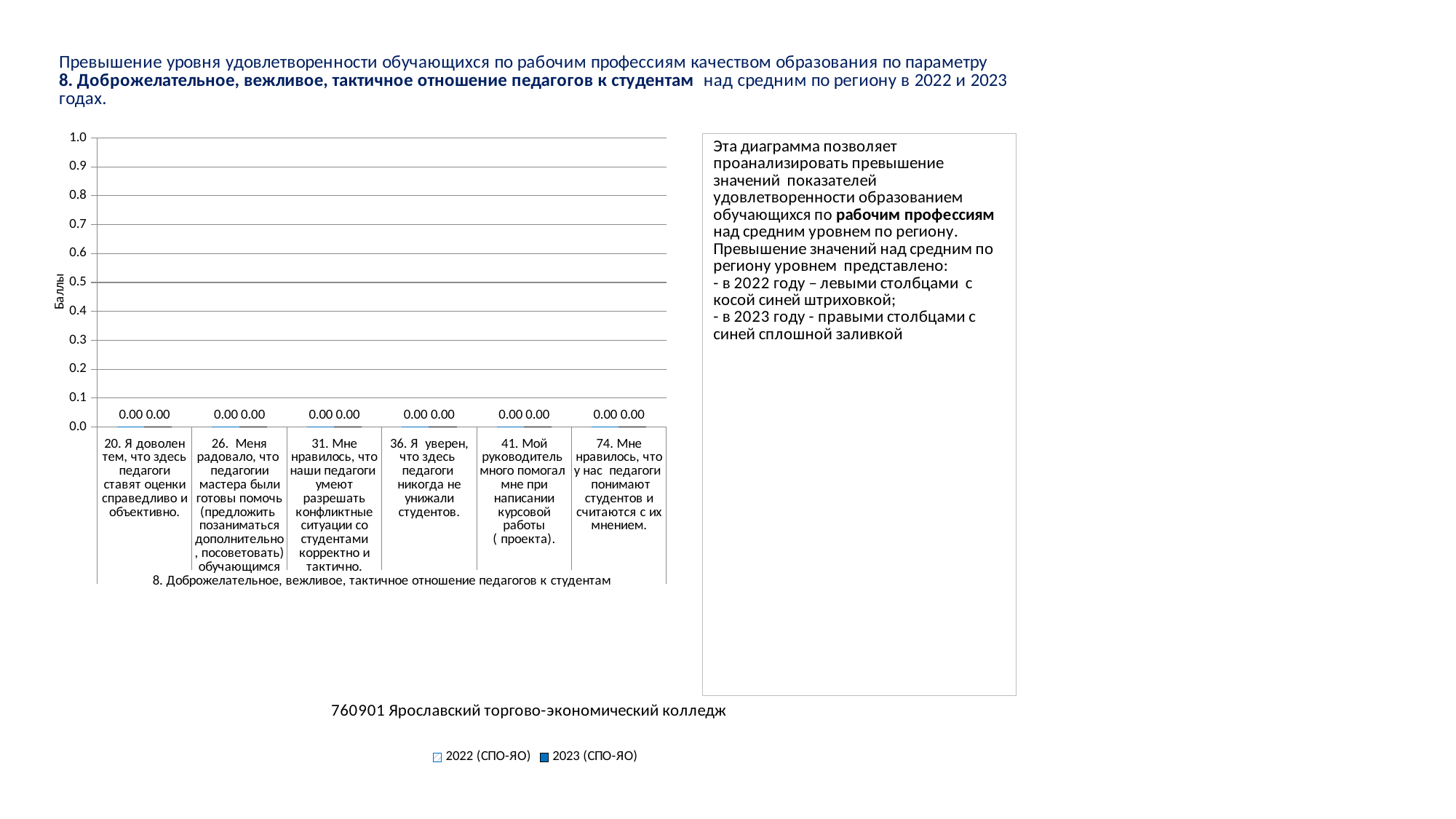
What is the 2023 (СПО-ЯО) value for category "74. Мне нравилось, что у нас педагоги понимают студентов и считаются с их мнением."? 0.00 What is the difference between the 2022 (СПО-ЯО) and 2023 (СПО-ЯО) values for category "31. Мне нравилось, что наши педагоги умеют разрешать конфликтные ситуации со студентами корректно и тактично."? 0.00 How many categories are shown on the x axis of the chart? 6 What kind of chart is shown on the slide? bar chart What is the label of the vertical axis of the chart? Баллы What is the 2023 (СПО-ЯО) value for category "20. Я доволен тем, что здесь педагоги ставят оценки справедливо и объективно."? 0.00 Do the values rise, fall, or stay the same across the categories along the x axis? stay the same How many series does the chart legend list? 2 What is the 2022 (СПО-ЯО) value for category "41. Мой руководитель много помогал мне при написании курсовой работы ( проекта)."? 0.00 What are the two series names listed in the chart legend? 2022 (СПО-ЯО) and 2023 (СПО-ЯО) What is the 2022 (СПО-ЯО) value for category "36. Я уверен, что здесь педагоги никогда не унижали студентов."? 0.00 Is the 2023 (СПО-ЯО) value for category "26. Меня радовало, что педагогии мастера были готовы помочь" greater or less than 0.5? less